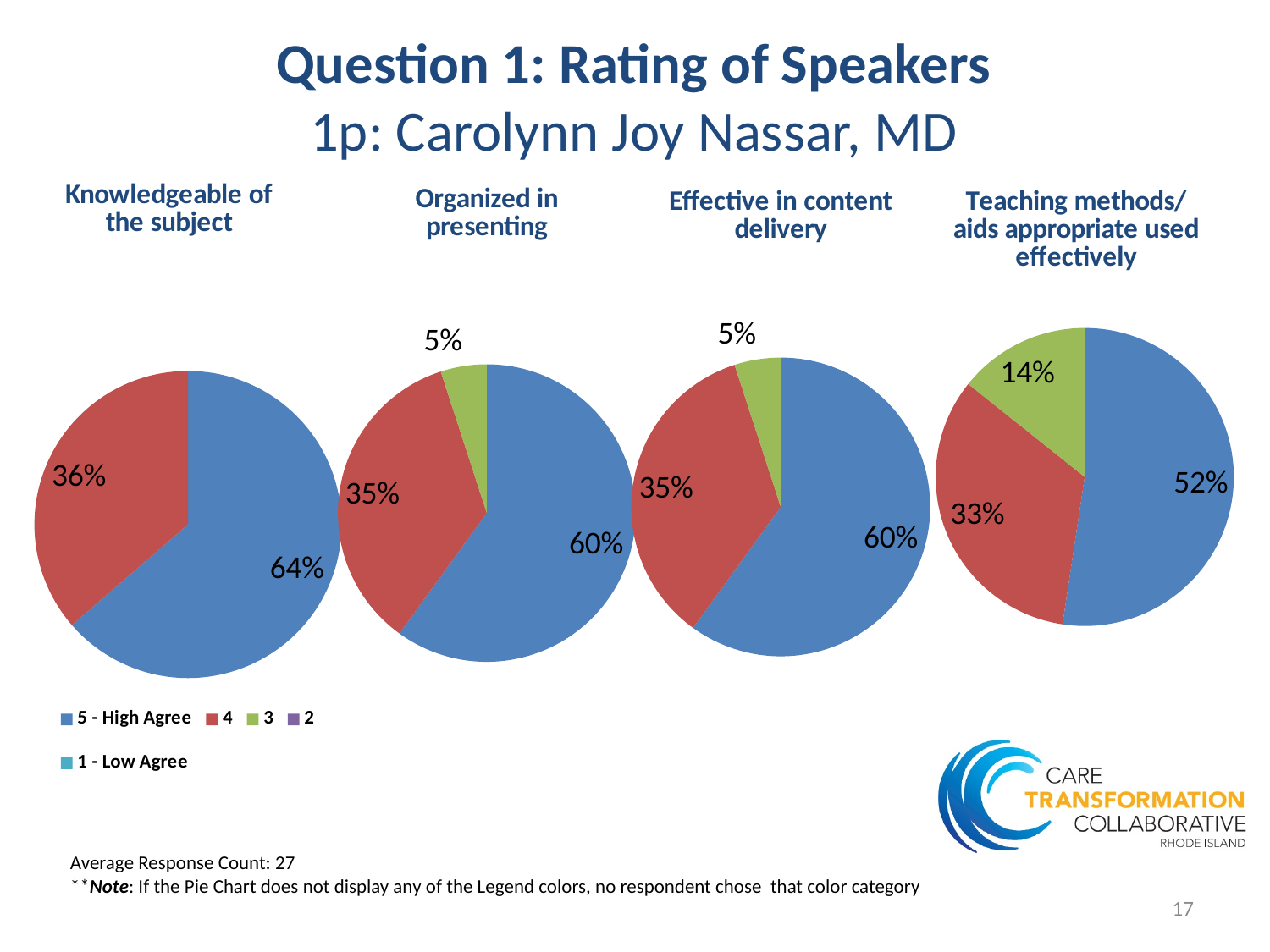
Which is larger: the '5 - High Agree' share in the 'Knowledgeable of the subject' chart or in the 'Teaching methods/aids appropriate used effectively' chart? Knowledgeable of the subject In the 'Knowledgeable of the subject' pie chart, what share of respondents chose '5 - High Agree'? 64% How many rating categories does the legend list? 5 In the 'Organized in presenting' pie chart, which rating has the smallest slice? 3 In the 'Teaching methods/aids appropriate used effectively' pie chart, what is the difference between the '5 - High Agree' share and the '4' share? 19% In the 'Teaching methods/aids appropriate used effectively' pie chart, what share of respondents chose '3'? 14% In the 'Effective in content delivery' pie chart, what share of respondents chose '5 - High Agree'? 60% What type of chart is used to show the ratings on this slide? Pie chart In the 'Knowledgeable of the subject' pie chart, what share of respondents chose '4'? 36% In the 'Teaching methods/aids appropriate used effectively' pie chart, which rating has the largest slice? 5 - High Agree In the 'Organized in presenting' pie chart, what share of respondents chose '3'? 5% How many slices does the 'Effective in content delivery' pie chart have? 3